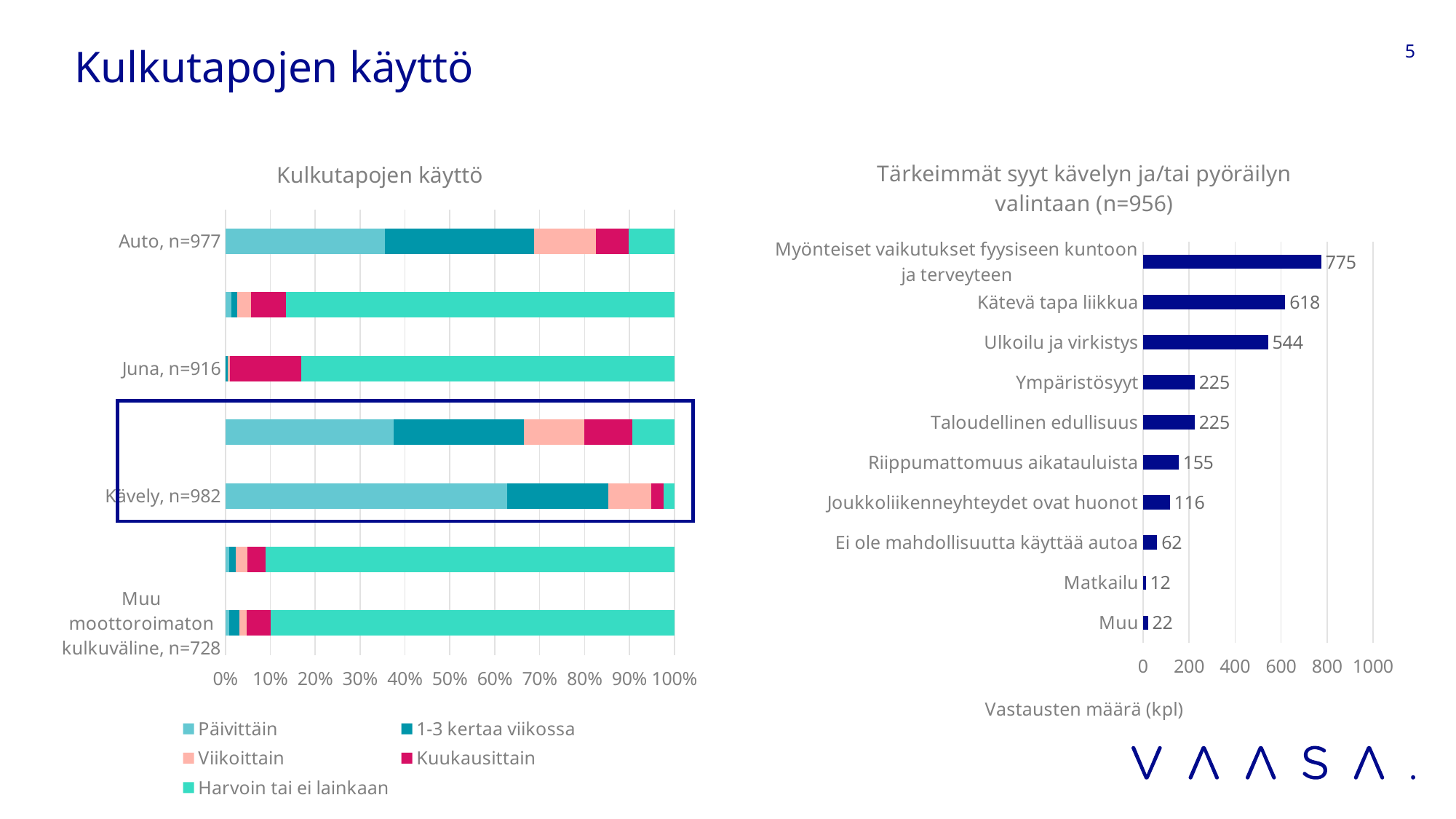
In the chart 'Tärkeimmät syyt kävelyn ja/tai pyöräilyn valintaan (n=956)', which is larger: 'Joukkoliikenneyhteydet ovat huonot' or 'Ei ole mahdollisuutta käyttää autoa'? Joukkoliikenneyhteydet ovat huonot What is the x-axis title of the chart 'Tärkeimmät syyt kävelyn ja/tai pyöräilyn valintaan (n=956)'? Vastausten määrä (kpl) In the chart 'Tärkeimmät syyt kävelyn ja/tai pyöräilyn valintaan (n=956)', what is the value for 'Riippumattomuus aikatauluista'? 155 In the chart 'Kulkutapojen käyttö', is the 'Harvoin tai ei lainkaan' share for 'Juna, n=916' greater or less than 70%? greater What kind of chart is the chart 'Kulkutapojen käyttö' on the left? Stacked bar chart In the chart 'Kulkutapojen käyttö', is the 'Päivittäin' share for 'Kävely, n=982' greater or less than 50%? greater How many categories are shown in the chart 'Tärkeimmät syyt kävelyn ja/tai pyöräilyn valintaan (n=956)'? 10 In the chart 'Tärkeimmät syyt kävelyn ja/tai pyöräilyn valintaan (n=956)', what is the difference between 'Ulkoilu ja virkistys' and 'Ympäristösyyt'? 319 In the chart 'Tärkeimmät syyt kävelyn ja/tai pyöräilyn valintaan (n=956)', what is the value for 'Kätevä tapa liikkua'? 618 In the chart 'Tärkeimmät syyt kävelyn ja/tai pyöräilyn valintaan (n=956)', which category has the highest value? Myönteiset vaikutukset fyysiseen kuntoon ja terveyteen How many series does the legend of the chart 'Kulkutapojen käyttö' list? 5 In the chart 'Tärkeimmät syyt kävelyn ja/tai pyöräilyn valintaan (n=956)', which category has the lowest value? Matkailu